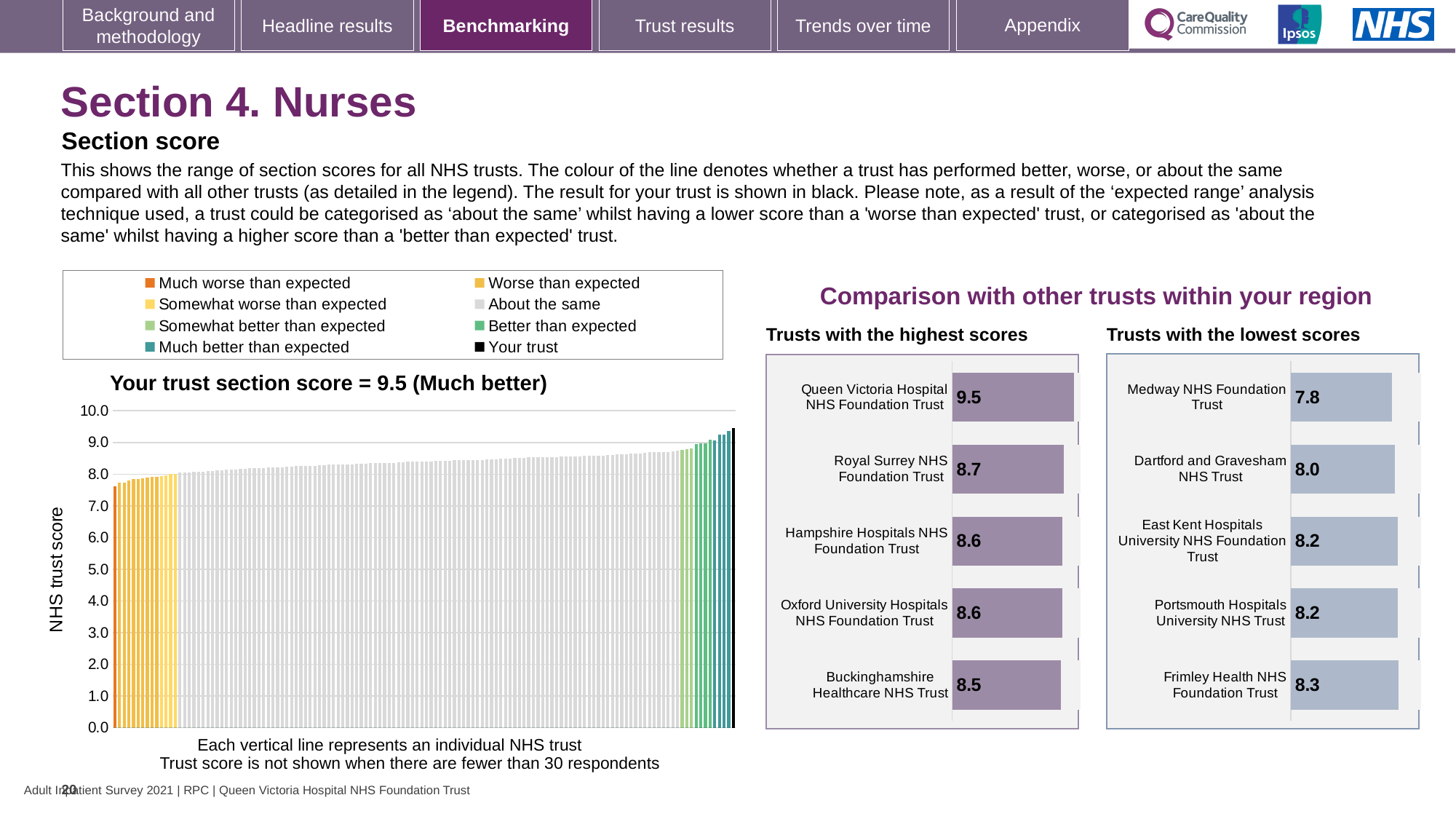
In the 'Trusts with the highest scores' chart, what is the difference between the scores of Queen Victoria Hospital NHS Foundation Trust and Royal Surrey NHS Foundation Trust? 0.8 In the 'Trusts with the lowest scores' chart, what is the difference between the scores of Frimley Health NHS Foundation Trust and Medway NHS Foundation Trust? 0.5 Which has a higher score: Dartford and Gravesham NHS Trust in the lowest scores chart or Hampshire Hospitals NHS Foundation Trust in the highest scores chart? Hampshire Hospitals NHS Foundation Trust In the 'Trusts with the highest scores' chart, what is the score for Royal Surrey NHS Foundation Trust? 8.7 In the 'Trusts with the lowest scores' chart, what is the score for Medway NHS Foundation Trust? 7.8 In the 'Trusts with the highest scores' chart, what is the score for Queen Victoria Hospital NHS Foundation Trust? 9.5 How many trusts are shown in the 'Trusts with the lowest scores' chart? 5 In the 'Trusts with the highest scores' chart, which trust has the lowest score? Buckinghamshire Healthcare NHS Trust In the 'Your trust section score' chart, is the value of the leftmost bar greater or less than 8.0? less In the 'Your trust section score' chart, do the bar values rise or fall from left to right? rise How many entries does the legend above the 'Your trust section score' chart list? 8 In the 'Trusts with the lowest scores' chart, which trust has the highest score? Frimley Health NHS Foundation Trust